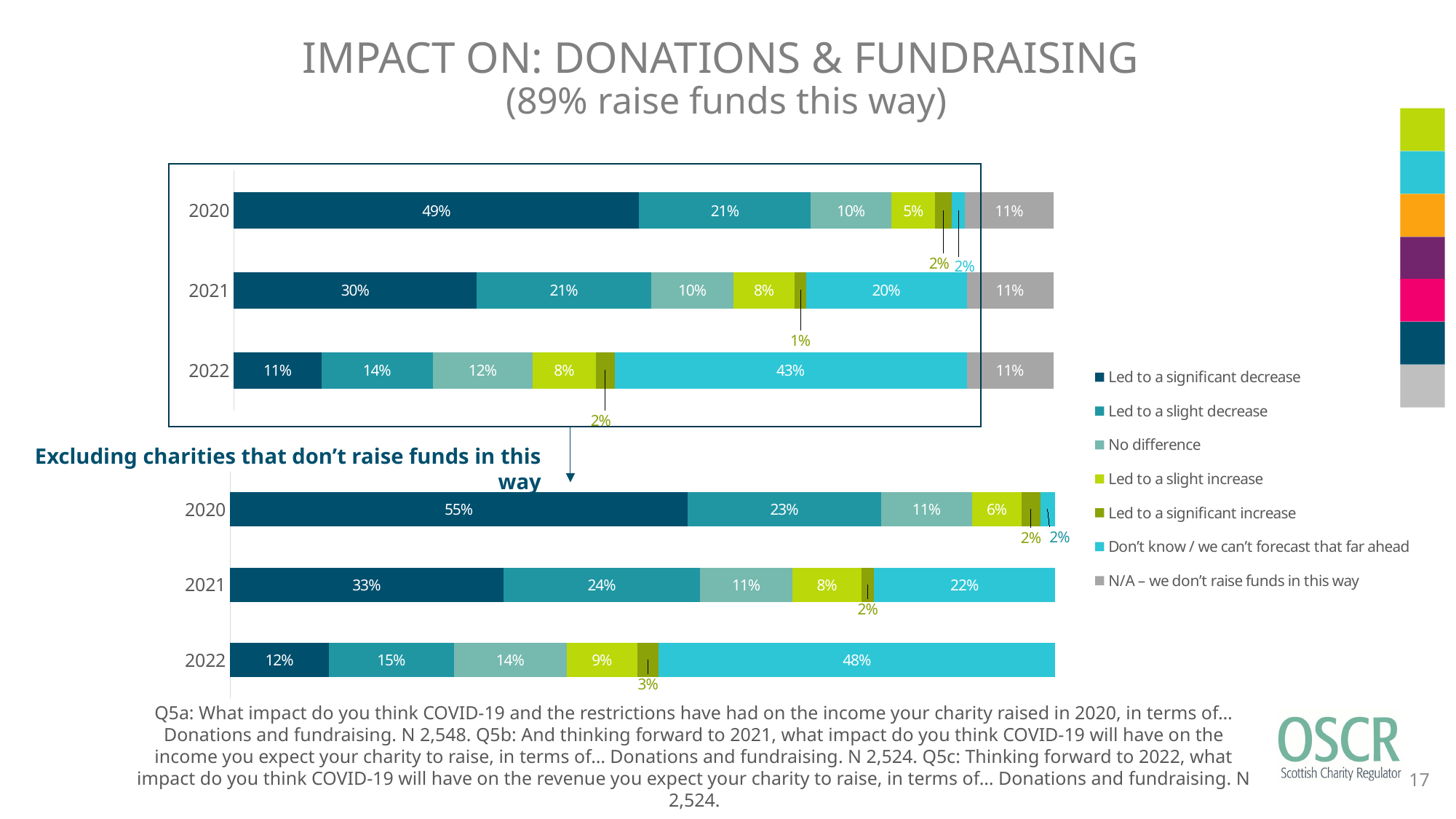
How many years are shown on the top chart? 3 In the top chart, does the 'Led to a significant decrease' value rise or fall from 2020 to 2022? Fall In the bottom chart (excluding charities that don't raise funds this way), what is the 'Led to a significant decrease' value for 2020? 55% In the top chart, what is the difference between the 'Led to a significant decrease' values for 2020 and 2022? 38 percentage points In the bottom chart, which is larger for 2021: 'Led to a slight decrease' or 'Don't know / we can't forecast that far ahead'? Led to a slight decrease In the bottom chart, what is the 'Led to a slight increase' value for 2022? 9% In the top chart, what percentage of respondents said COVID-19 led to a significant decrease in donations and fundraising in 2020? 49% What type of chart is used on this slide? Stacked bar chart In the top chart, what is the 'Don't know / we can't forecast that far ahead' value for 2022? 43% How many series does the legend list? 7 In the top chart, which year has the highest 'Led to a significant decrease' value? 2020 In the bottom chart, which year has the lowest 'Don't know / we can't forecast that far ahead' value? 2020